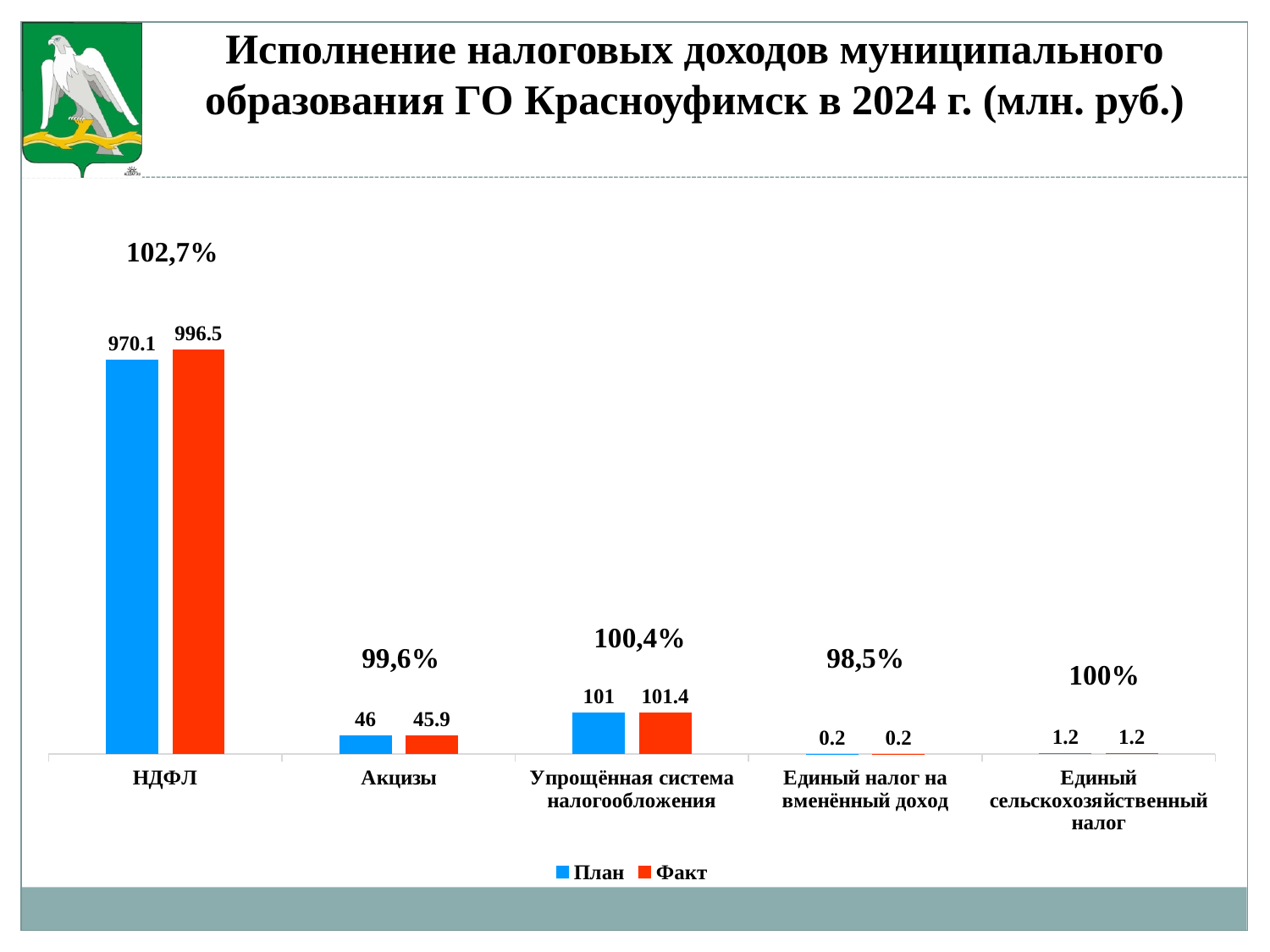
What is the Факт value for НДФЛ? 996.5 Which is larger for Акцизы, the План value or the Факт value? План What is the difference between the Факт and План values for НДФЛ? 26.4 How many categories are shown on the x axis? 5 How many series does the legend list? 2 What is the План value for Упрощённая система налогообложения? 101 What kind of chart is shown on the slide? Bar chart What is the Факт value for Акцизы? 45.9 Which category has the lowest План value? Единый налог на вменённый доход Which category has the highest Факт value? НДФЛ What is the Факт value for Единый сельскохозяйственный налог? 1.2 What is the План value for НДФЛ? 970.1